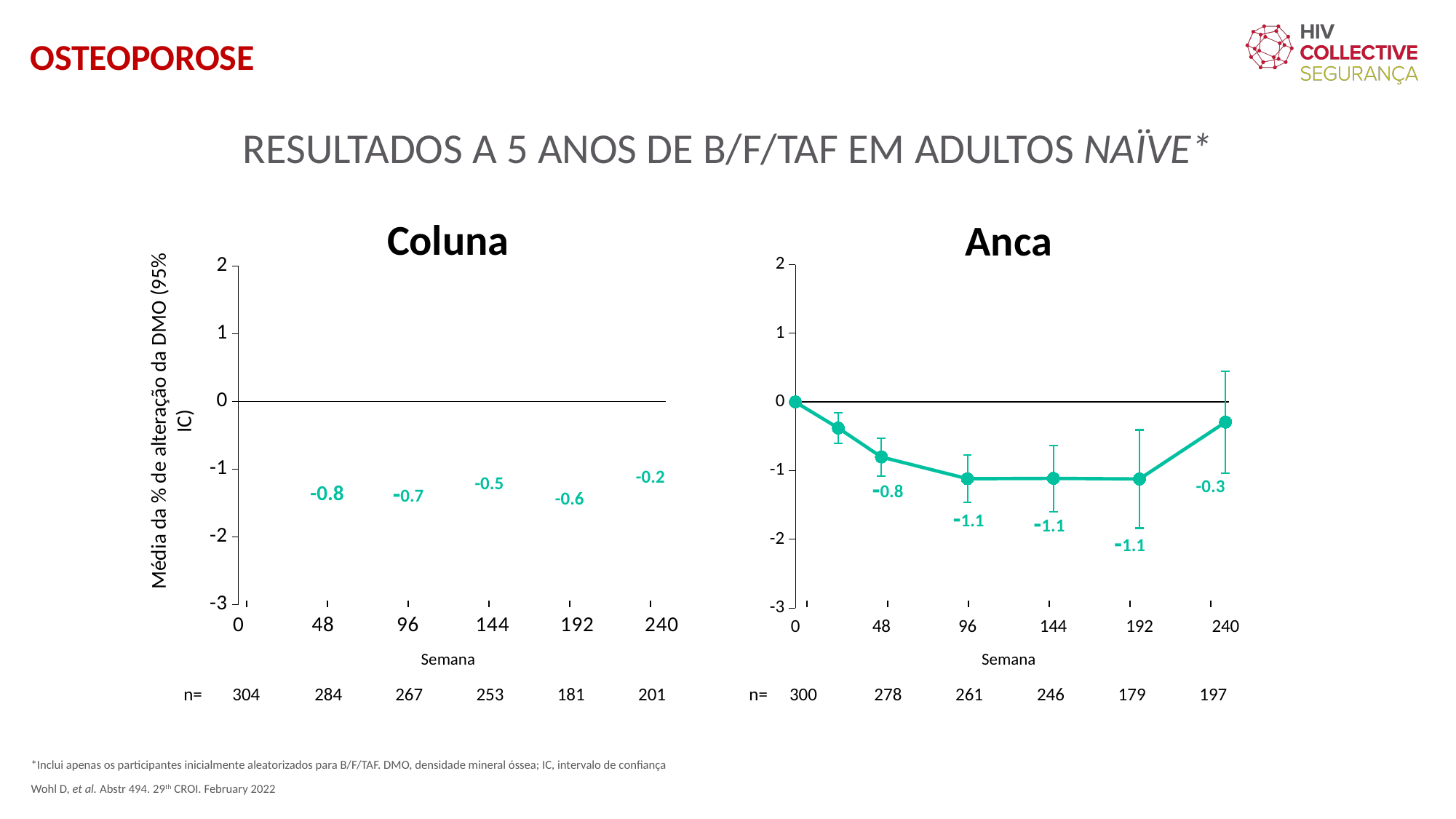
What kind of chart is the Anca chart? line chart In the Coluna chart, what is the mean % change in BMD at week 48? -0.8 In the Anca chart, which is larger, the value at week 48 or the value at week 96? week 48 What is the x-axis label of the Coluna chart? Semana In the Coluna chart, at which week is the labelled value lowest? 48 In the Anca chart, does the value rise or fall between week 192 and week 240? rise In the Coluna chart, what is the difference between the values at week 48 and week 240? 0.6 In the Anca chart, what is the value labelled at week 240? -0.3 In the Coluna chart, what is the value shown at week 240? -0.2 In the Anca chart, what is the value labelled at week 96? -1.1 In the Coluna chart, at which week is the labelled value highest? 240 In the Anca chart, is the value at week 48 greater or less than -1? greater